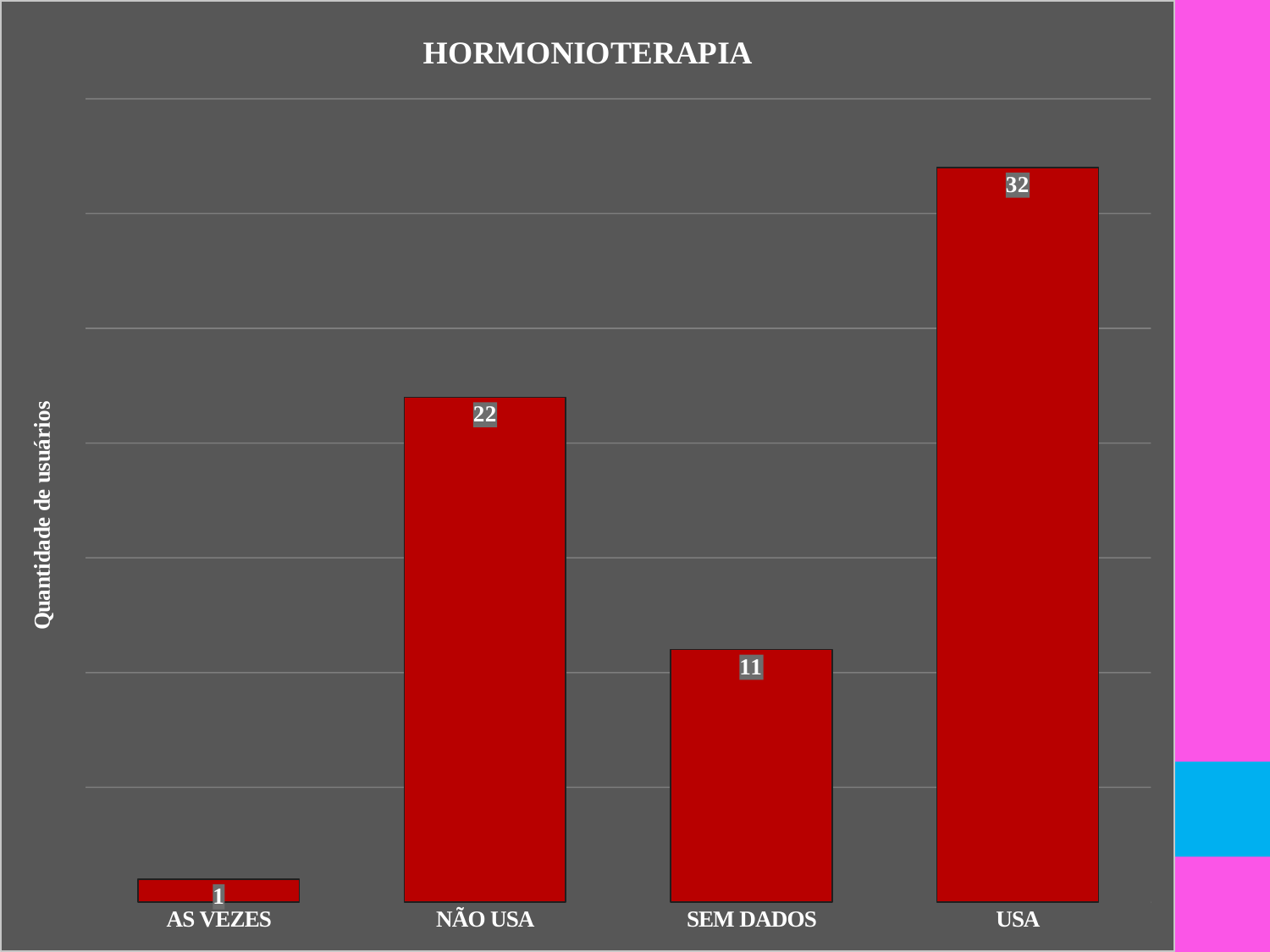
What is the difference between the values for NÃO USA and SEM DADOS? 11 How many categories are shown on the x axis? 4 What is the title of the chart? HORMONIOTERAPIA What is the value for AS VEZES? 1 What is the value for SEM DADOS? 11 Which category has the highest value? USA What is the value for NÃO USA? 22 What kind of chart is this? bar chart Which category has the lowest value? AS VEZES What is the difference between the values for USA and NÃO USA? 10 Which is larger, the value for SEM DADOS or the value for NÃO USA? NÃO USA What is the value for USA? 32